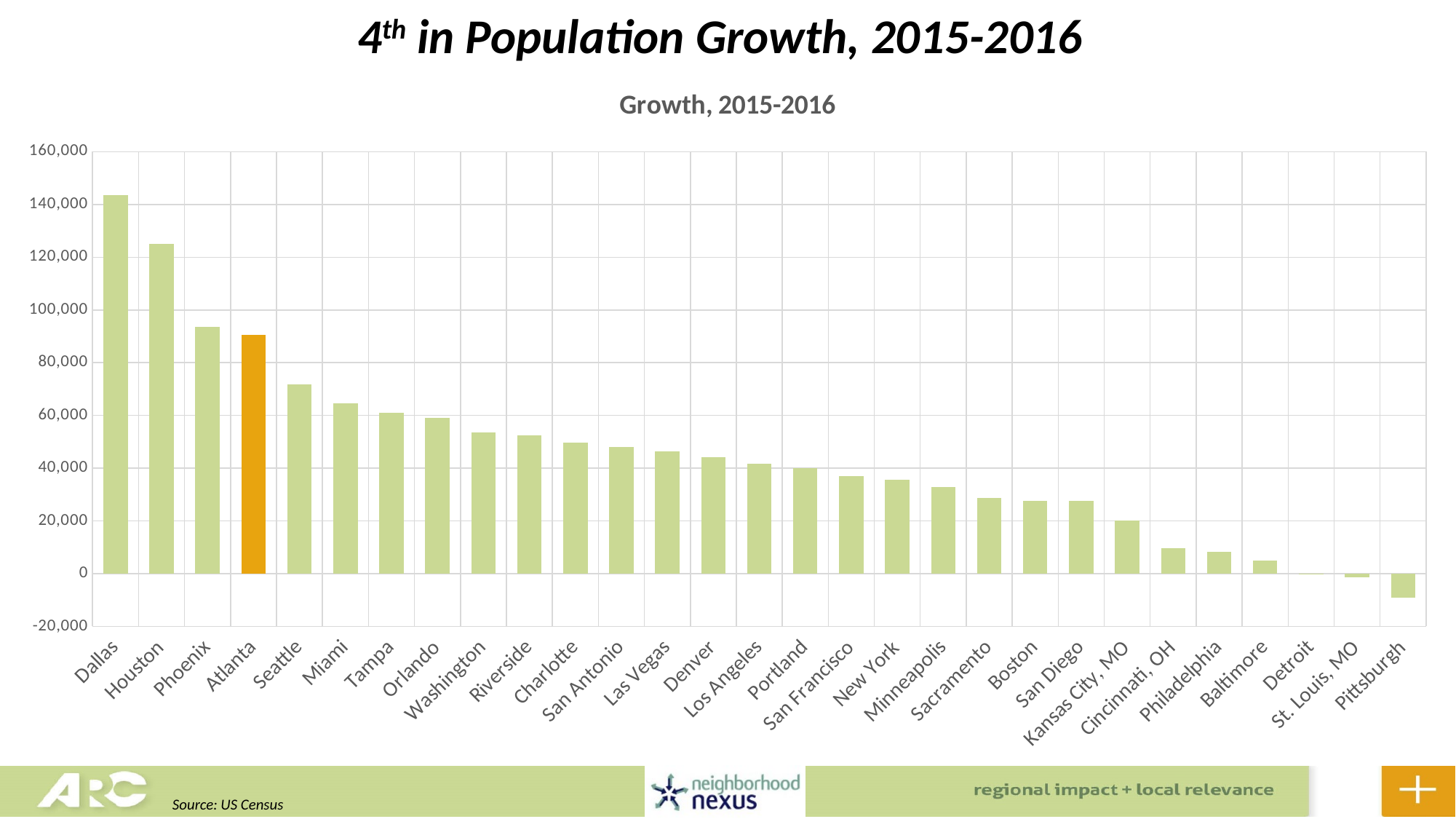
How many cities are shown on the x axis of the chart? 29 Which city has the lowest population growth in the chart? Pittsburgh Which city's bar is highlighted in orange? Atlanta Which city has the highest population growth in the chart? Dallas Is the value for Atlanta greater or less than 80,000? greater Is the value for Cincinnati, OH greater or less than 20,000? less Is the value for Dallas greater or less than 140,000? greater Do the values generally rise or fall moving from left to right along the x axis? fall What kind of chart is shown on the slide? bar chart Which has the larger population growth, Houston or Phoenix? Houston